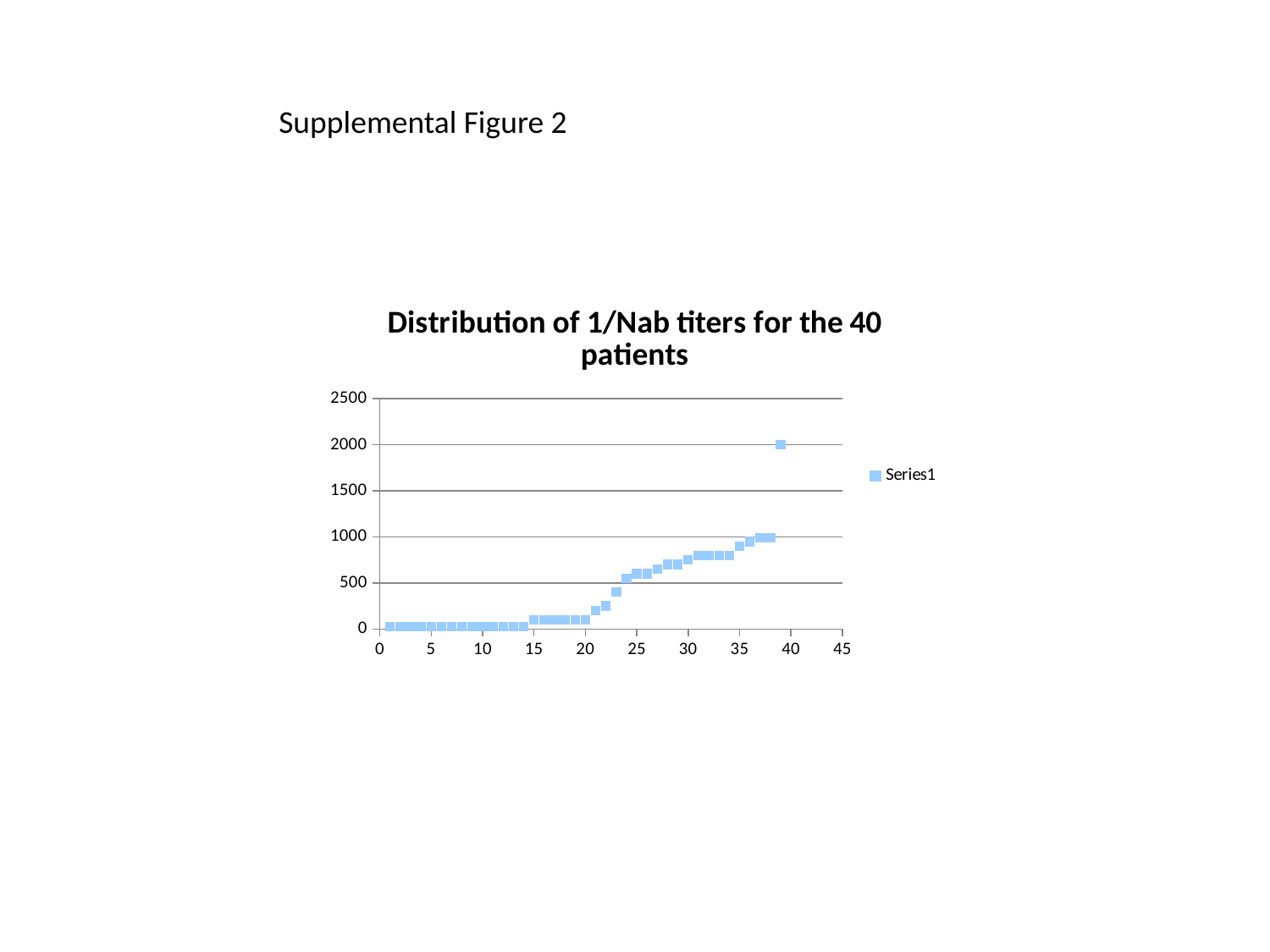
Is the highest point on the chart located between x = 35 and x = 40? yes Is the value of the highest point on the chart greater or less than 1500? greater According to the chart title, how many patients are represented? 40 What is the name of the series shown in the legend? Series1 Is the value for the point at x = 10 greater or less than 500? less Is the value for the point at x = 35 greater or less than 500? greater How many series does the legend list? 1 Do the plotted values generally rise or fall as the x value increases? rise What is the title of the chart? Distribution of 1/Nab titers for the 40 patients What kind of chart is shown on the slide? scatter chart